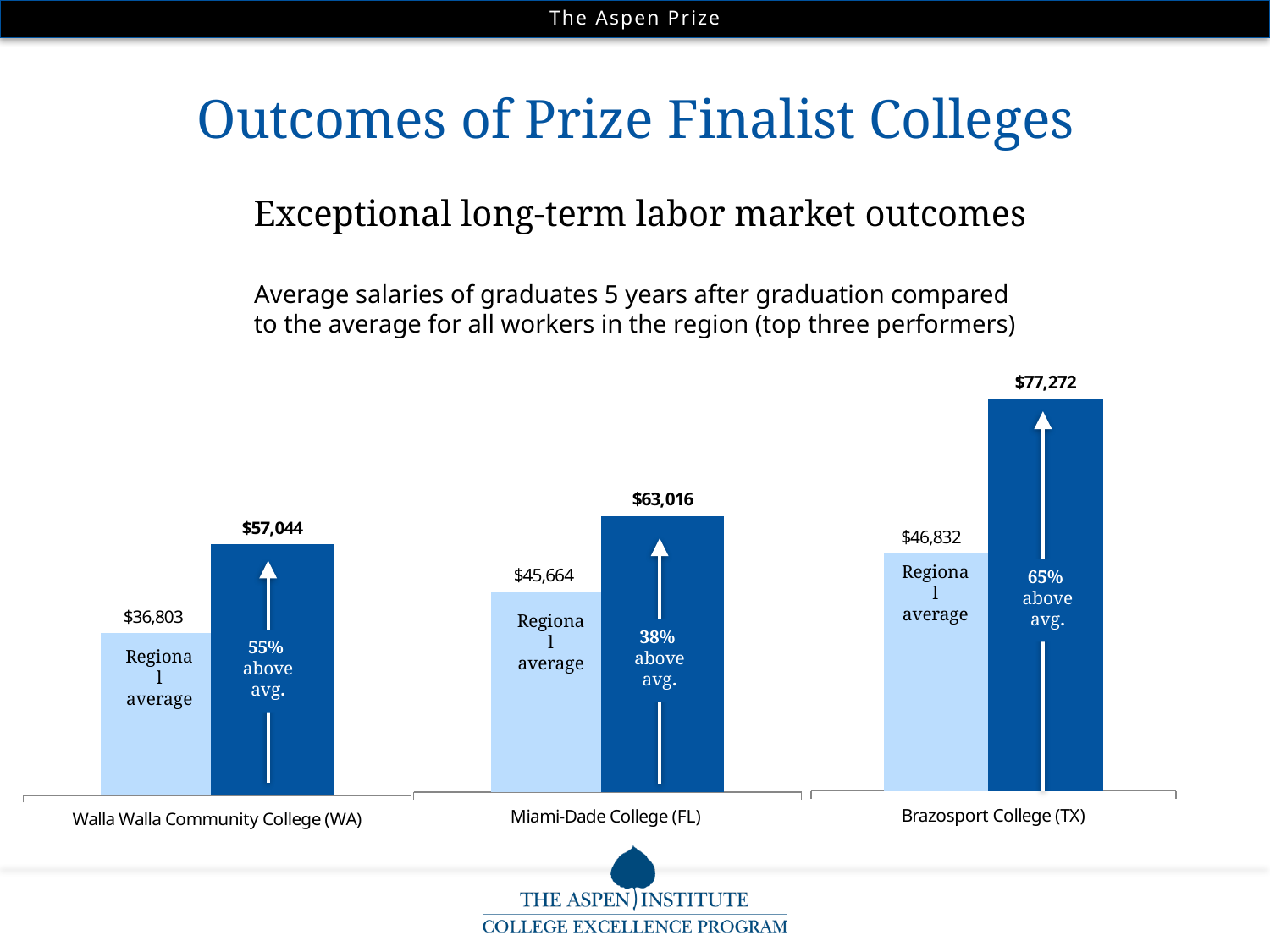
By what percentage are Brazosport College (TX) graduate salaries above the regional average? 65% What is the difference between the graduate salary and the regional average for Brazosport College (TX)? $30,440 What kind of chart is shown on the slide? Bar chart What is the average salary of graduates 5 years after graduation for Walla Walla Community College (WA)? $57,044 Which college has the lowest regional average salary? Walla Walla Community College (WA) What is the graduate salary shown for Brazosport College (TX)? $77,272 What is the regional average salary shown for Walla Walla Community College (WA)? $36,803 Which is larger: the graduate salary for Miami-Dade College (FL) or the graduate salary for Walla Walla Community College (WA)? Miami-Dade College (FL) How many colleges are shown in the chart? 3 Which college has the highest graduate salary 5 years after graduation? Brazosport College (TX) What is the regional average salary shown for Miami-Dade College (FL)? $45,664 What is the difference between the graduate salary and the regional average for Walla Walla Community College (WA)? $20,241